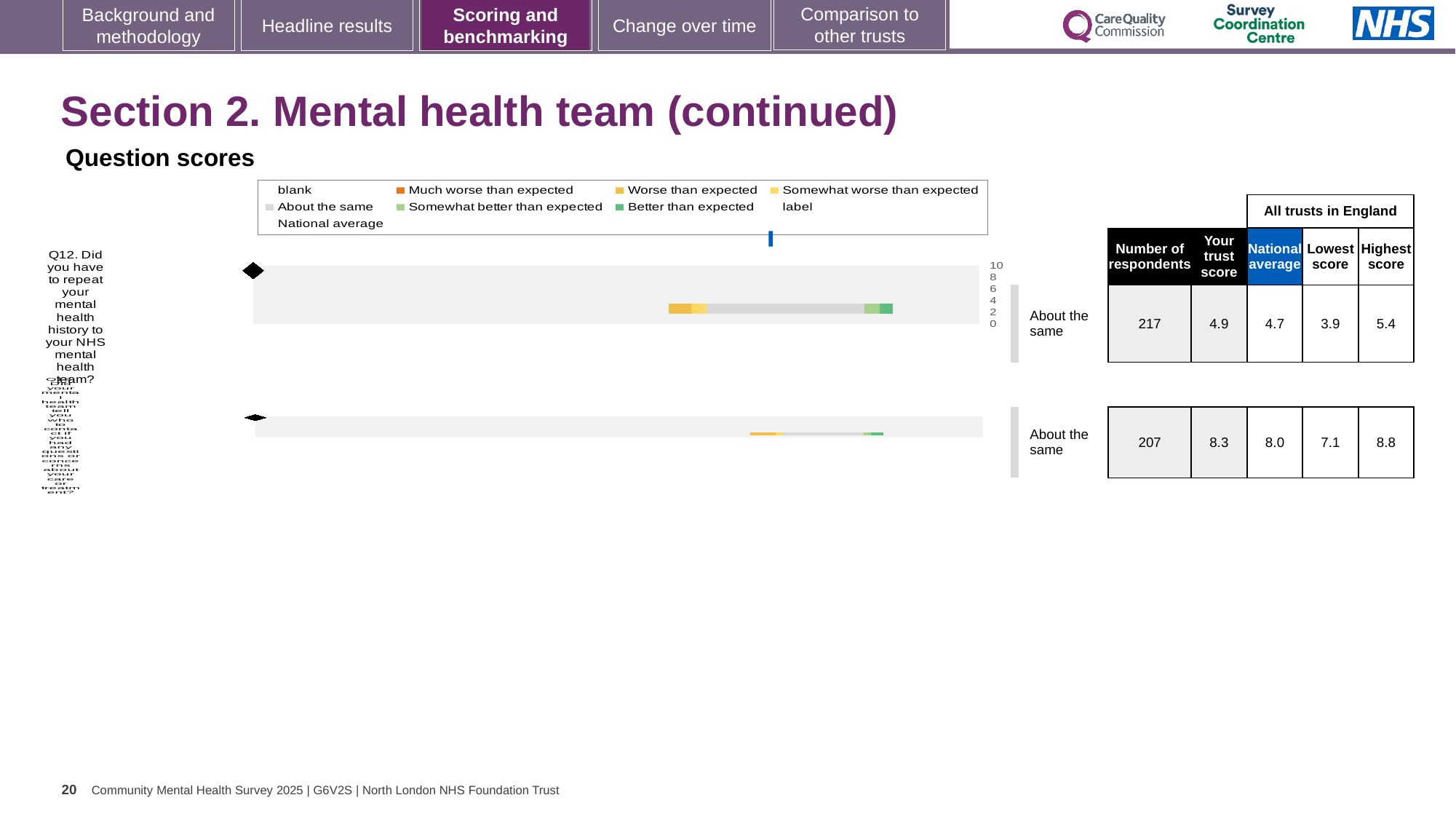
For Q12 (repeating your mental health history), what is the trust's score shown in the table? 4.9 For Q12, what is the national average score? 4.7 What type of chart is used to show the question scores on this slide? bar chart For the lower chart on the slide, what is the trust's score? 8.3 What benchmark rating is given to Q12? About the same How many respondents answered Q12? 217 For the lower chart, what is the difference between the trust's score and the national average? 0.3 For Q12, what is the difference between the highest and lowest scores among all trusts in England? 1.5 Which of the two questions on the slide had more respondents, Q12 or the question in the lower chart? Q12 For the lower chart on the slide, what is the lowest score among all trusts in England? 7.1 For Q12, what is the highest score among all trusts in England? 5.4 For Q12, is the trust's score higher or lower than the national average? higher